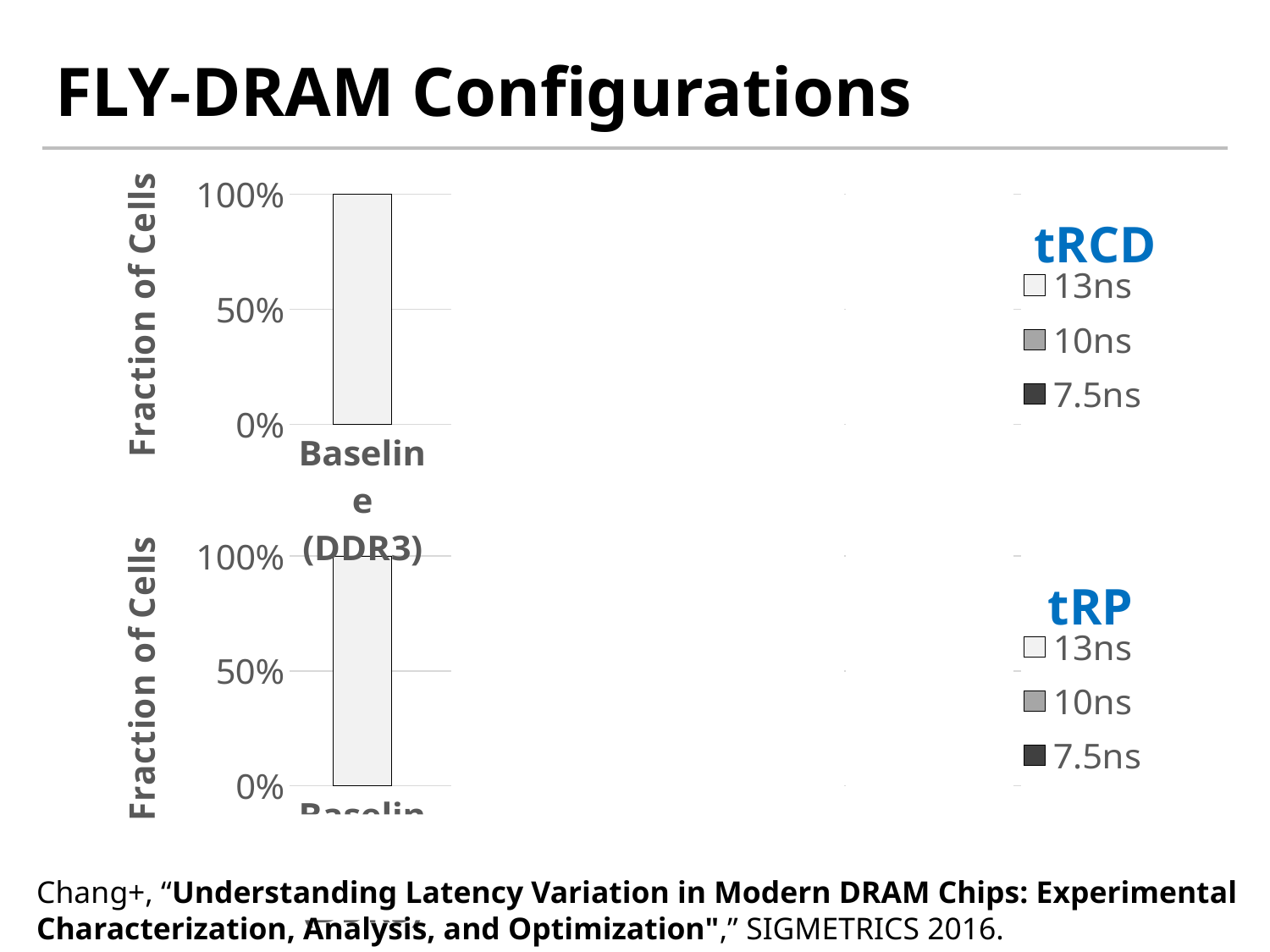
What are the three legend entries of the bottom chart (tRP)? 13ns, 10ns, 7.5ns In the top chart (tRCD), is the value for Baseline (DDR3) greater or less than 50%? greater What is the y-axis label of the top chart (tRCD)? Fraction of Cells What kind of chart is the top chart (tRCD)? bar chart How many bars are plotted in the bottom chart (tRP)? 1 In the bottom chart (tRP), is the value of the plotted bar greater or less than 50%? greater What kind of chart is the bottom chart (tRP)? bar chart How many series does the legend of the bottom chart (tRP) list? 3 In the bottom chart (tRP), what Fraction of Cells does the single plotted bar reach? 100% How many categories are plotted on the x axis of the top chart (tRCD)? 1 In the top chart (tRCD), what is the Fraction of Cells for Baseline (DDR3)? 100% How many series does the legend of the top chart (tRCD) list? 3